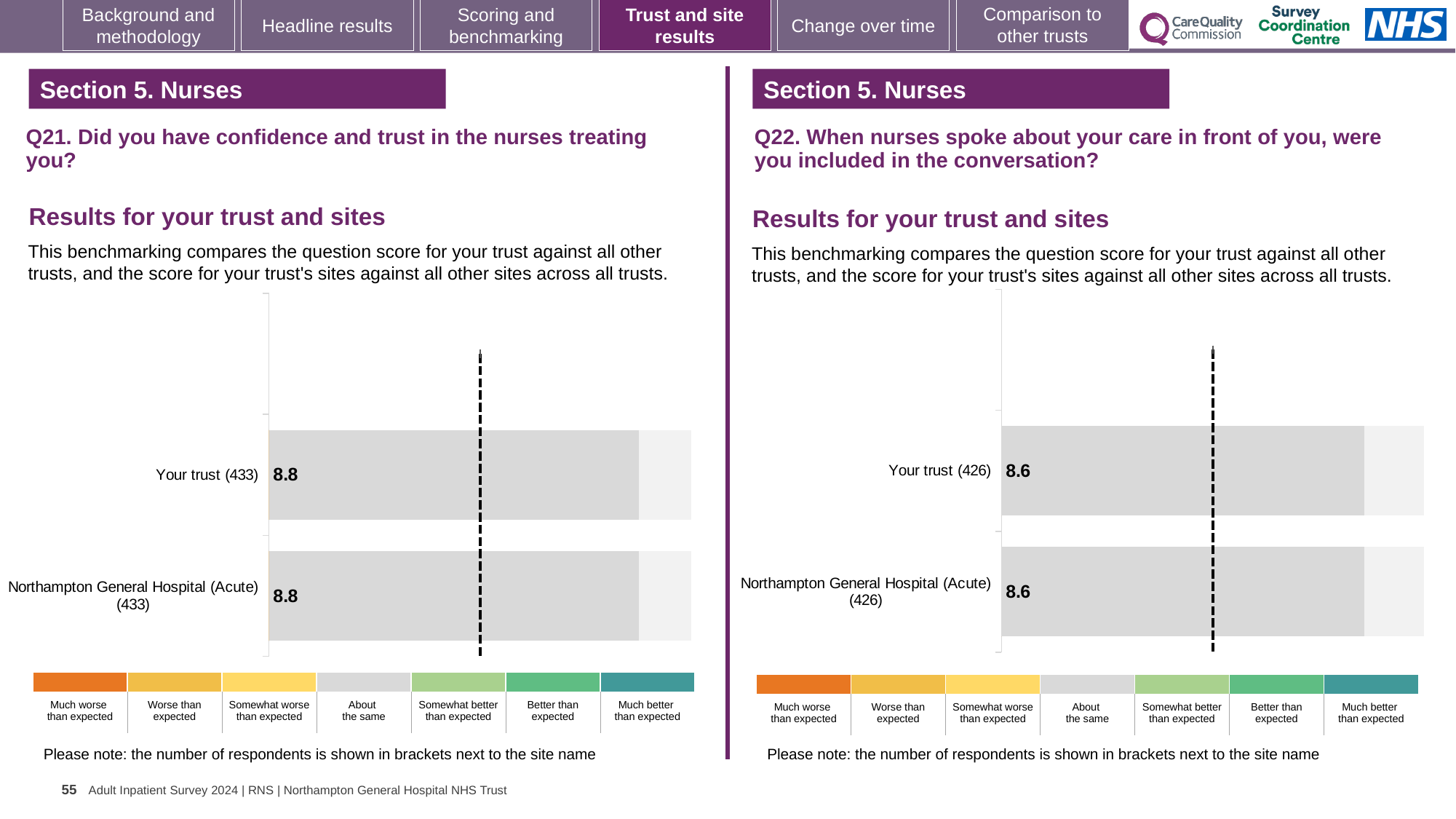
On the Q21 chart (left), what is the score for Your trust (433)? 8.8 On the Q22 chart (right), which benchmark category does the grey colour of the bars correspond to in the legend? About the same How many bars are plotted on the Q21 chart (left)? 2 On the Q21 chart (left), how many respondents are shown in brackets for Your trust? 433 On the Q22 chart (right), what is the score for Northampton General Hospital (Acute) (426)? 8.6 What kind of chart is the Q21 chart (left)? Bar chart On the Q21 chart (left), what is the difference between the score for Your trust and the score for Northampton General Hospital (Acute)? 0 On the Q21 chart (left), what is the score for Northampton General Hospital (Acute) (433)? 8.8 On the Q22 chart (right), what is the score for Your trust (426)? 8.6 How many bars are plotted on the Q22 chart (right)? 2 Is the score for Your trust on the Q21 chart (left) larger or smaller than the score for Your trust on the Q22 chart (right)? Larger On the Q22 chart (right), what is the difference between the score for Your trust and the score for Northampton General Hospital (Acute)? 0